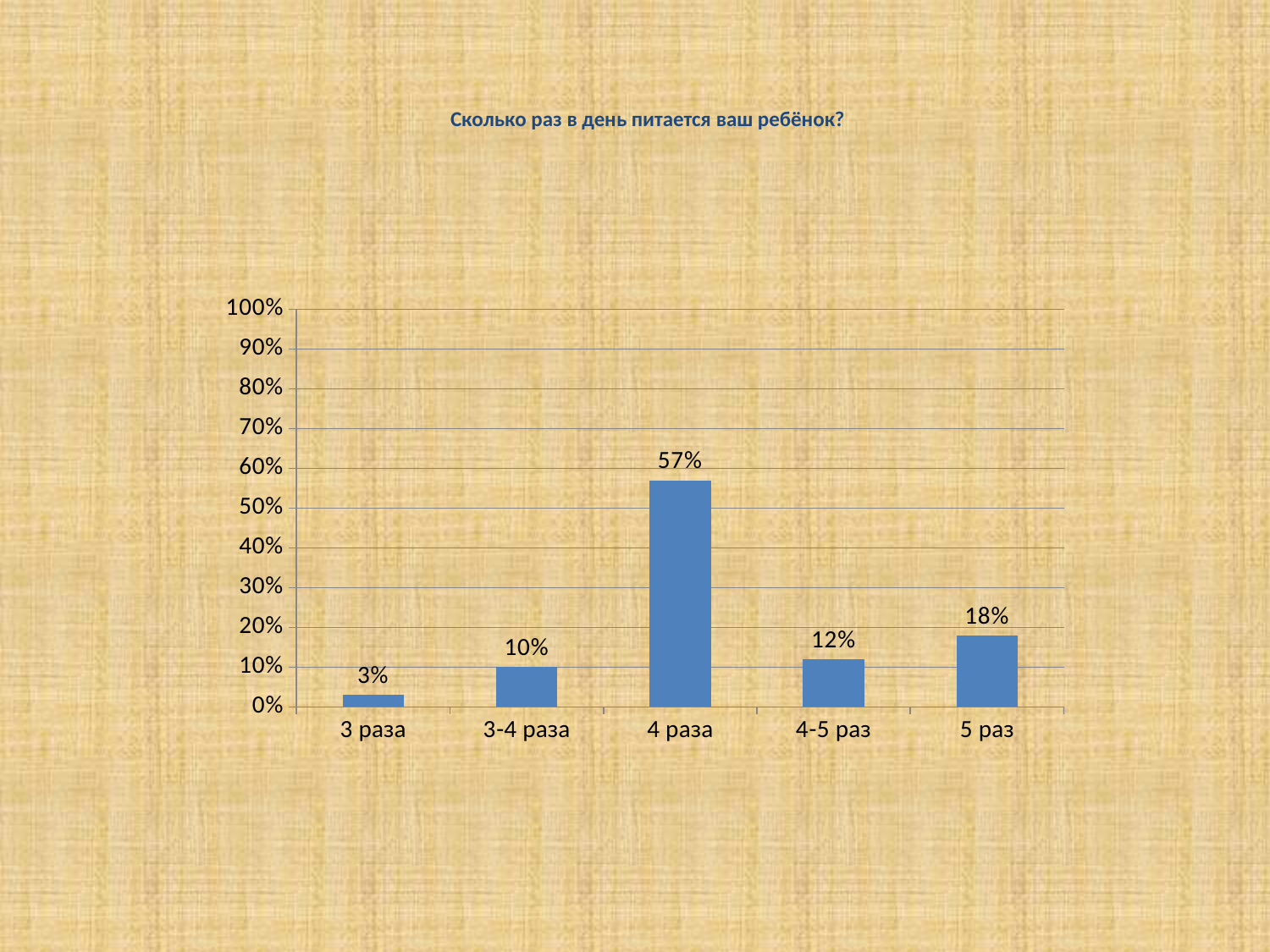
What is the value for "5 раз"? 18% What is the difference between the values for "4-5 раз" and "3-4 раза"? 2% Is the value for "4 раза" greater or less than 50%? greater Which category has the highest value? 4 раза What is the difference between the values for "4 раза" and "5 раз"? 39% What is the title of the slide? Сколько раз в день питается ваш ребёнок? How many categories are shown on the x axis? 5 What is the value for "4 раза"? 57% What kind of chart is shown on the slide? bar chart Which is larger, the value for "5 раз" or the value for "4-5 раз"? 5 раз Which category has the lowest value? 3 раза What is the value for "3 раза"? 3%